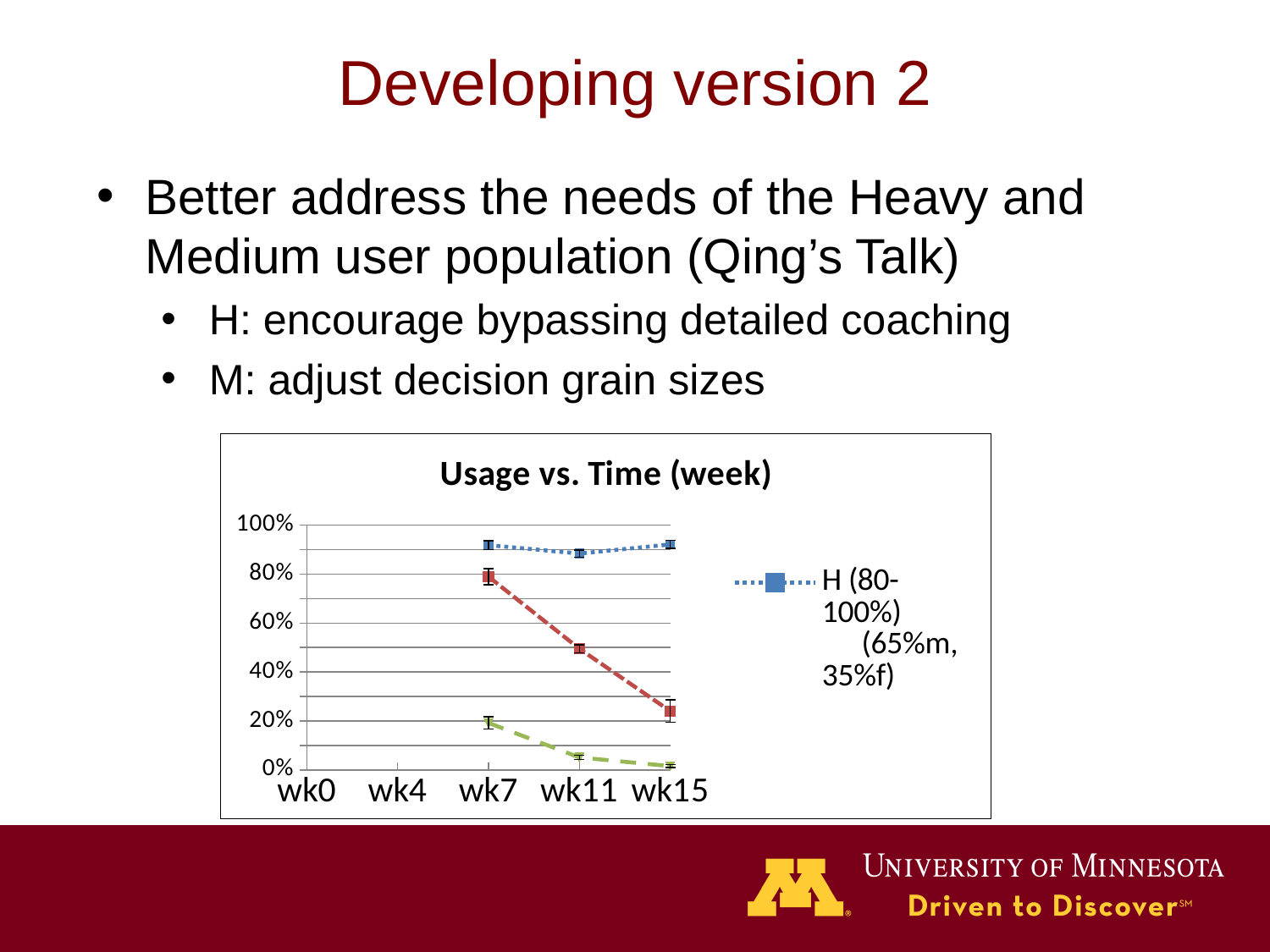
Is the value of the red dashed series at wk15 greater or less than 40%? less At wk15, which is larger: the H (80-100%) series or the red dashed series? H (80-100%) What kind of chart is shown on the slide? line chart Is the value of the H (80-100%) series at wk7 greater or less than 80%? greater Is the value of the red dashed series at wk7 greater or less than 60%? greater Does the red dashed series rise or fall from wk7 to wk15? fall How many lines are plotted in the chart? 3 How many week labels are shown on the x axis of the chart? 5 What is the title of the chart? Usage vs. Time (week) Does the green dashed series rise or fall from wk7 to wk15? fall Which series is named in the chart's legend? H (80-100%) (65%m, 35%f)